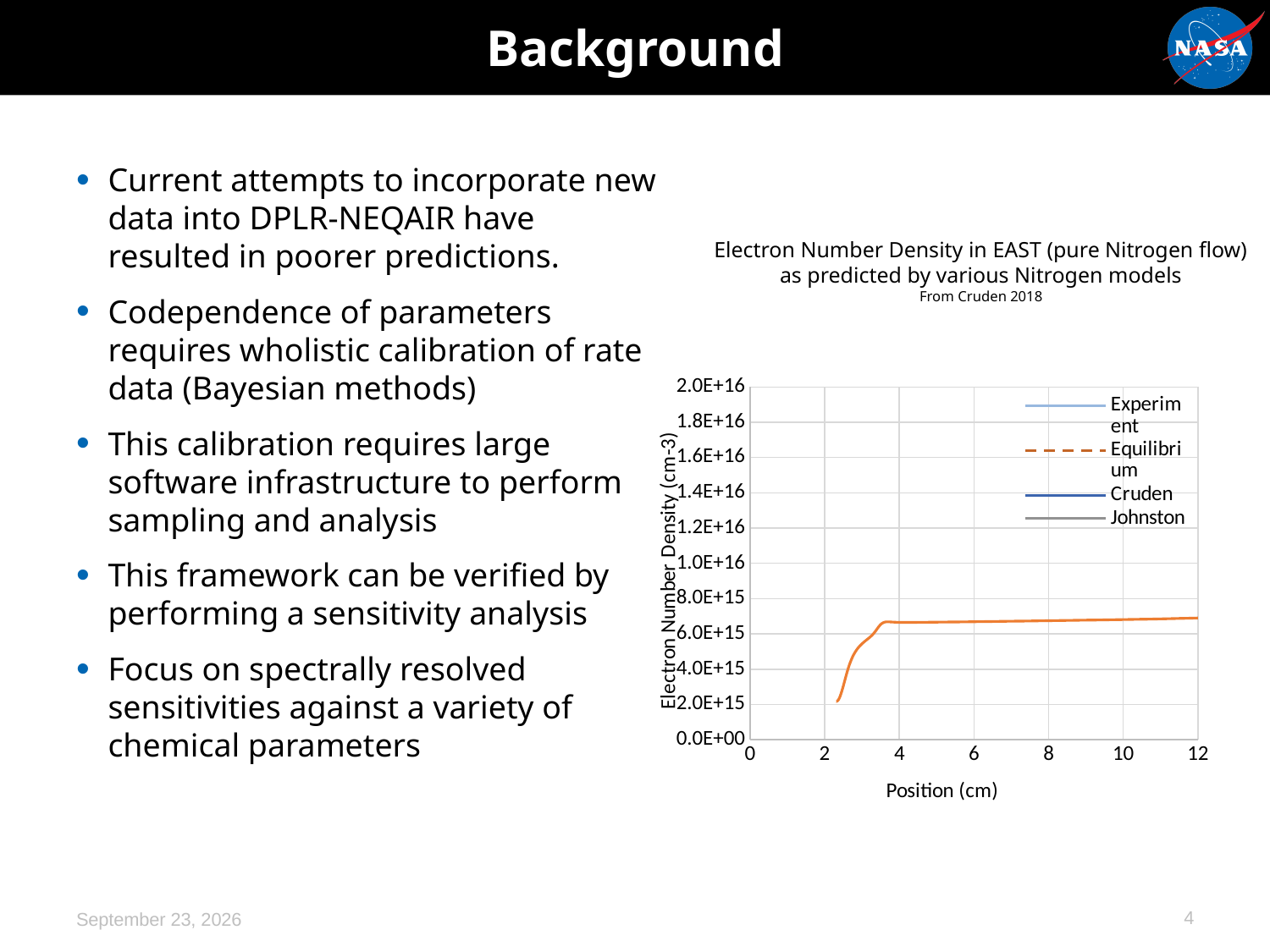
What is the label of the x axis of the chart? Position (cm) Does the plotted electron number density rise or fall as position increases from 2 cm to 4 cm? rise Is the plotted electron number density at a position of 10 cm greater or less than 6.0E+15? greater What is the title of the chart? Electron Number Density in EAST (pure Nitrogen flow) as predicted by various Nitrogen models What is the maximum value shown on the x axis of the chart? 12 How many series does the chart's legend list? 4 Is the plotted electron number density at a position of 6 cm greater or less than 8.0E+15? less Is the plotted electron number density at a position of 8 cm greater or less than 1.0E+16? less What kind of chart is shown on the slide? line chart